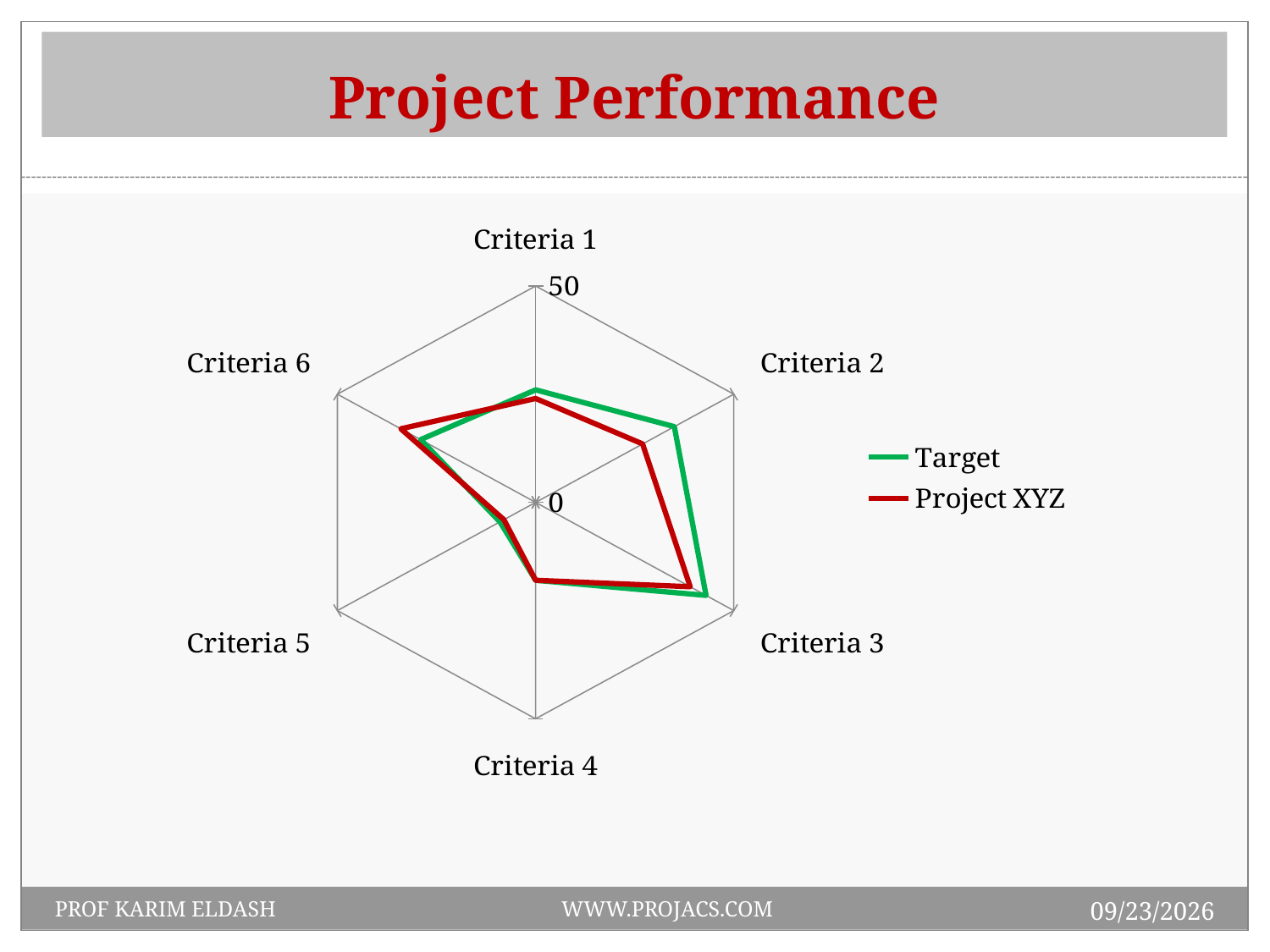
Is the Target value for Criteria 3 greater or less than 50? less Which series is drawn in red? Project XYZ For which criteria does the Project XYZ series reach its highest value? Criteria 3 For which criteria does the Target series have its lowest value? Criteria 5 How many series does the legend list? 2 What is the title of the chart? Project Performance At Criteria 6, which series has the larger value, Target or Project XYZ? Project XYZ How many criteria (categories) are plotted on the chart? 6 What kind of chart is shown on the slide? Radar chart At Criteria 2, which series has the larger value, Target or Project XYZ? Target For which criteria does the Project XYZ series have its lowest value? Criteria 5 For which criteria does the Target series reach its highest value? Criteria 3